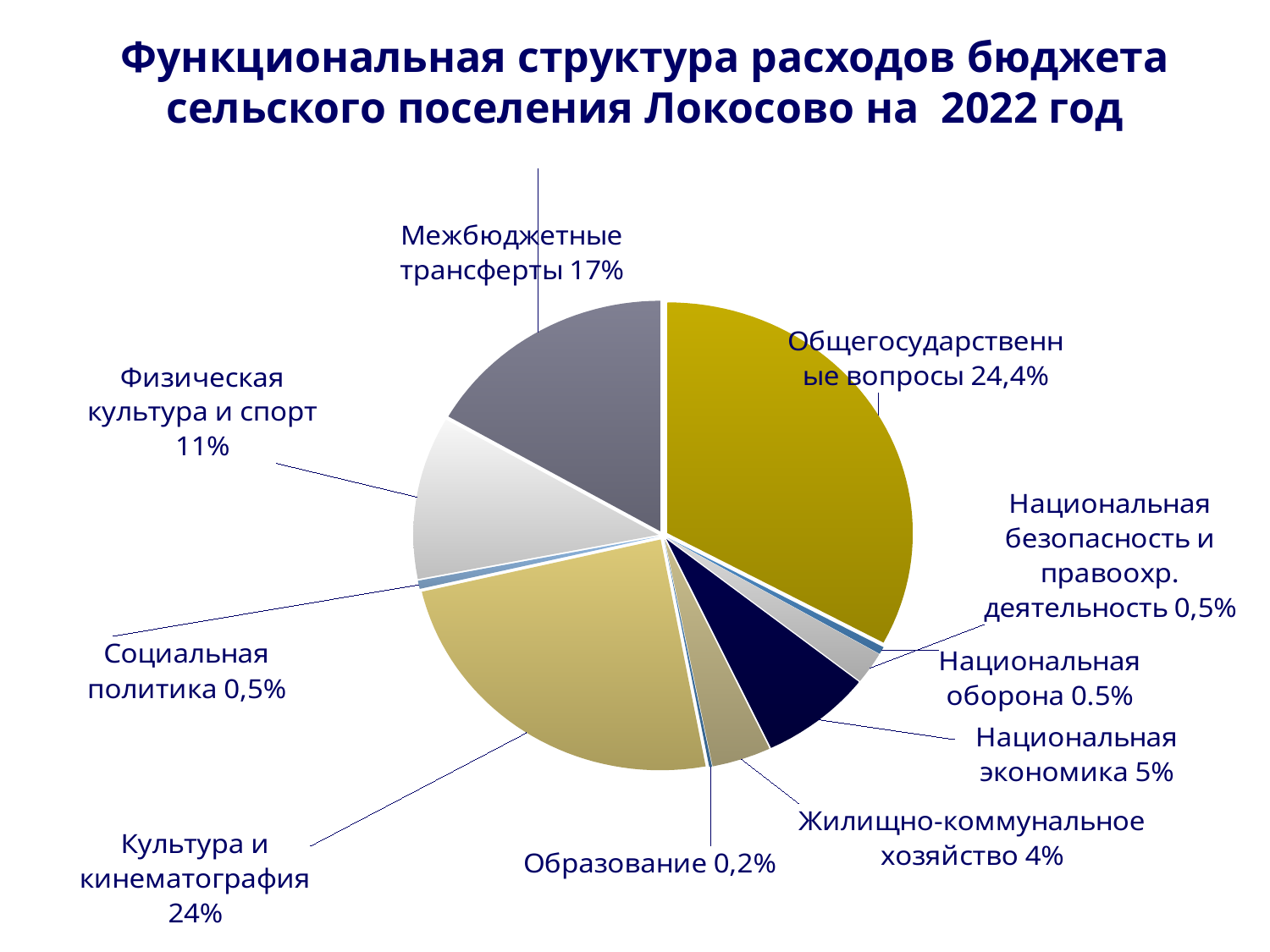
What kind of chart is shown on the slide? Pie chart What share of the budget goes to Общегосударственные вопросы? 24,4% What is the difference in percentage points between Межбюджетные трансферты and Физическая культура и спорт? 6 What share of the budget goes to Межбюджетные трансферты? 17% What share of the budget goes to Жилищно-коммунальное хозяйство? 4% Which has a larger share: Национальная экономика or Жилищно-коммунальное хозяйство? Национальная экономика How many categories (slices) does the pie chart have? 10 Which category has the largest share of the budget? Общегосударственные вопросы What share of the budget goes to Физическая культура и спорт? 11% For which year does the chart show the functional structure of budget expenditures of the Локосово rural settlement? 2022 Which category has the smallest share of the budget? Образование What share of the budget goes to Образование? 0,2%